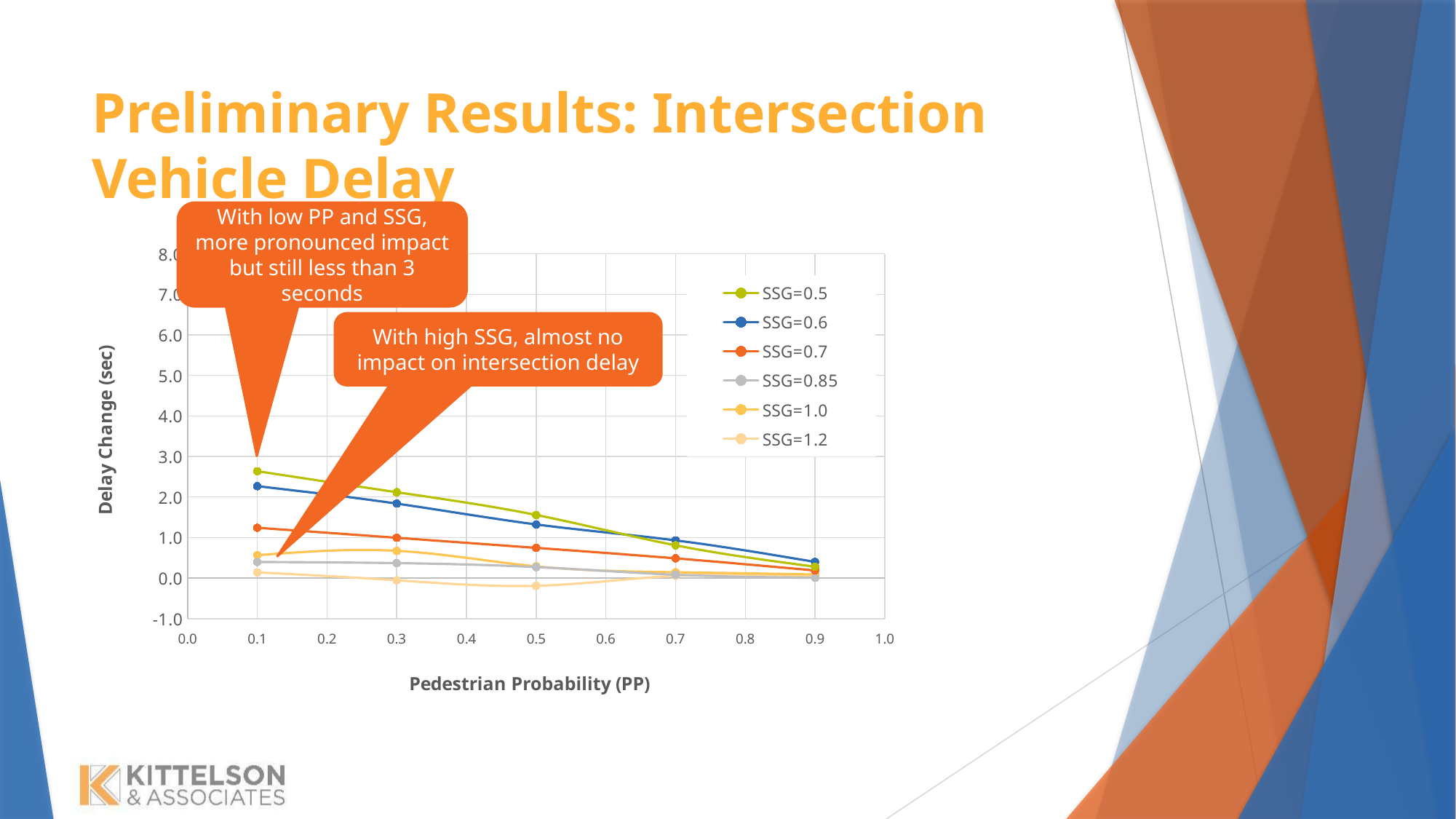
Is the delay change for SSG=0.5 at PP=0.1 greater or less than 3.0? less How many data points are plotted for the SSG=0.5 series? 5 Does the delay change for SSG=0.5 rise or fall as Pedestrian Probability increases? fall At PP=0.1, which series has the larger delay change, SSG=0.7 or SSG=0.85? SSG=0.7 At PP=0.5, which series has the larger delay change, SSG=0.5 or SSG=0.6? SSG=0.5 Which series has the lowest delay change at PP=0.1? SSG=1.2 What is the title of the x axis of the chart? Pedestrian Probability (PP) Which series has the highest delay change at PP=0.1? SSG=0.5 How many series does the legend list? 6 Is the delay change for SSG=0.6 at PP=0.1 greater or less than 2.0? greater Is the delay change for SSG=0.7 at PP=0.1 greater or less than 1.0? greater What kind of chart is shown on the slide? line chart